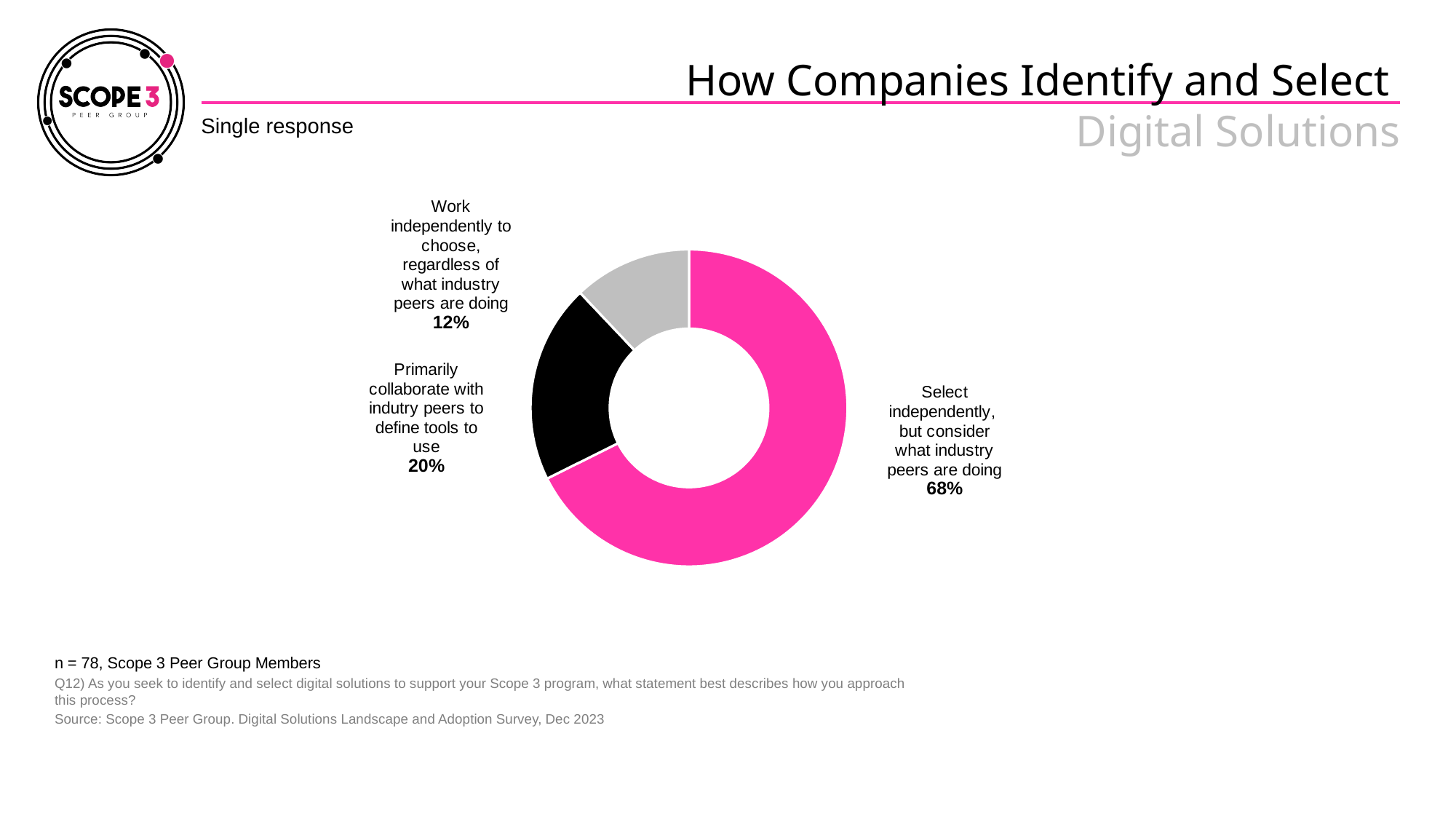
Which approach has the largest share of the chart? Select independently, but consider what industry peers are doing What is the difference in percentage points between 'Primarily collaborate with industry peers to define tools to use' and 'Work independently to choose, regardless of what industry peers are doing'? 8 percentage points How many categories are shown in the chart? 3 What is the difference in percentage points between 'Select independently, but consider what industry peers are doing' and 'Primarily collaborate with industry peers to define tools to use'? 48 percentage points What colour is the segment for 'Select independently, but consider what industry peers are doing'? Pink What percentage of companies work independently to choose, regardless of what industry peers are doing? 12% What percentage of companies select independently, but consider what industry peers are doing? 68% What is the sample size (n) stated for the chart? 78 Which is larger: the share for 'Primarily collaborate with industry peers to define tools to use' or the share for 'Work independently to choose, regardless of what industry peers are doing'? Primarily collaborate with industry peers to define tools to use What percentage of companies primarily collaborate with industry peers to define tools to use? 20% Which approach has the smallest share of the chart? Work independently to choose, regardless of what industry peers are doing What type of chart is shown on the slide? Doughnut chart